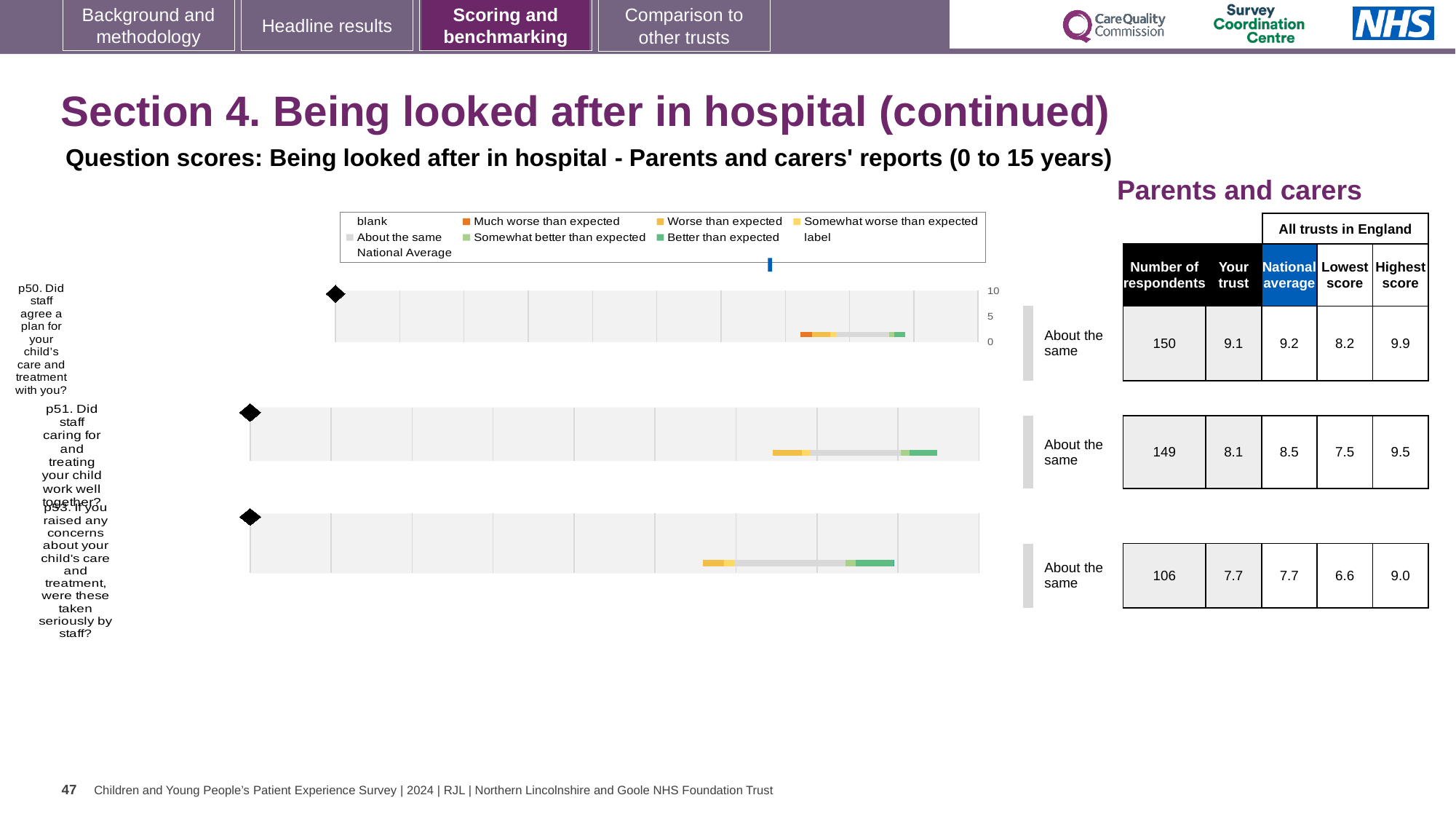
What benchmark category label is shown next to each of the three question bars? About the same Which question has the highest 'Your trust' score? p50 For question p51, what is the difference between the highest score and the lowest score across all trusts in England? 2.0 What is the 'Your trust' score for question p50 (Did staff agree a plan for your child's care and treatment with you?)? 9.1 How many questions (p50, p51, p53) have a benchmark bar plotted on the slide? 3 What kind of chart is used to show the question scores on this slide? bar chart What is the national average score for question p51 (Did staff caring for and treating your child work well together?)? 8.5 How many respondents are recorded for question p53 (If you raised any concerns about your child's care and treatment, were these taken seriously by staff?)? 106 For question p50, which is larger: the 'Your trust' score or the national average? National average Which question has the lowest number of respondents? p53 What is the highest score across all trusts in England for question p50? 9.9 What is the subtitle above the charts describing the question scores? Question scores: Being looked after in hospital - Parents and carers' reports (0 to 15 years)